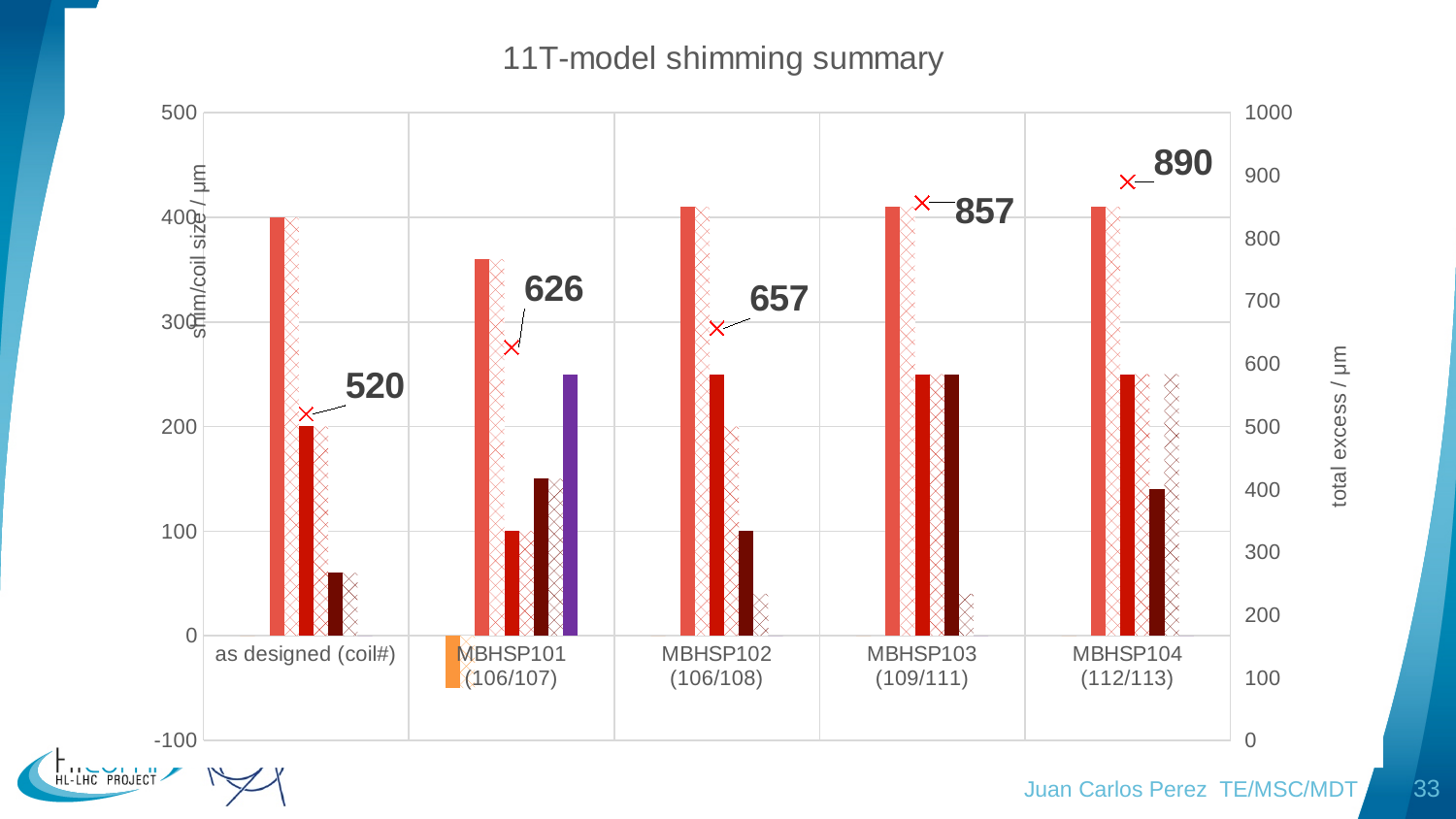
Is the value of the purple bar for MBHSP101 (106/107) greater or less than 200 on the left axis? greater What is the difference between the labelled total excess values for MBHSP103 (109/111) and MBHSP102 (106/108)? 200 What is the total excess value labelled for MBHSP104 (112/113)? 890 Which category has the highest labelled total excess value? MBHSP104 (112/113) Which has a larger labelled total excess value, MBHSP101 (106/107) or MBHSP102 (106/108)? MBHSP102 (106/108) Which category has the lowest labelled total excess value? as designed (coil#) How many categories are shown on the x axis? 5 What is the total excess value labelled for MBHSP102 (106/108)? 657 What is the difference between the labelled total excess values for MBHSP104 (112/113) and 'as designed (coil#)'? 370 What is the total excess value labelled for the 'as designed (coil#)' category? 520 What is the title of the right-hand vertical axis? total excess / µm Do the labelled total excess values rise or fall from left to right across the categories? rise